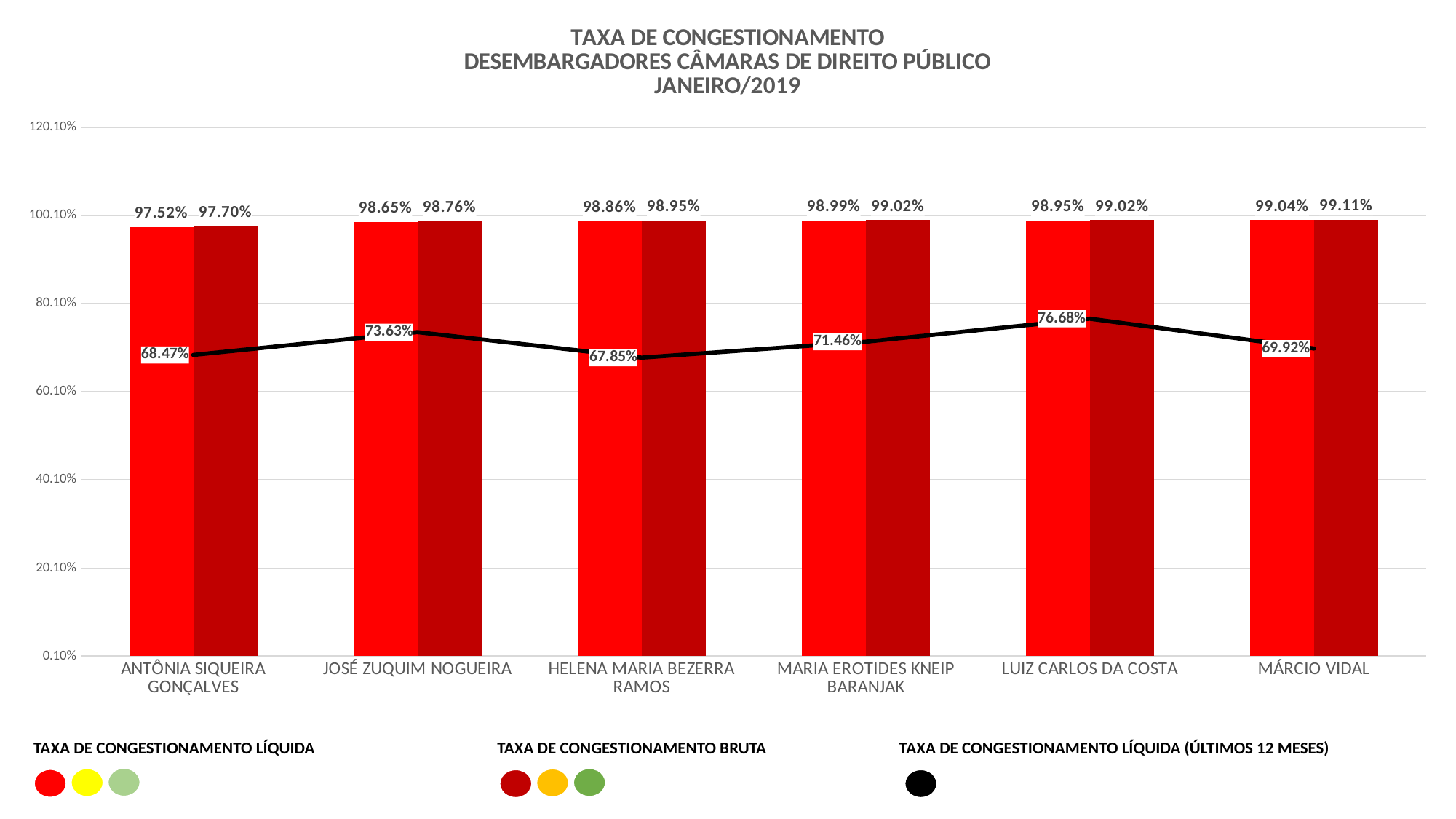
What is the Taxa de Congestionamento Líquida (últimos 12 meses) for Helena Maria Bezerra Ramos? 67.85% What is the Taxa de Congestionamento Bruta for Márcio Vidal? 99.11% Which desembargador has the highest Taxa de Congestionamento Líquida (últimos 12 meses)? Luiz Carlos da Costa What is the Taxa de Congestionamento Líquida for Antônia Siqueira Gonçalves? 97.52% How many desembargadores are shown on the x axis? 6 What is the difference between the Taxa de Congestionamento Bruta and the Taxa de Congestionamento Líquida for José Zuquim Nogueira? 0.11% What kind of chart is this? Bar chart with a line Which is larger: the Taxa de Congestionamento Líquida (últimos 12 meses) for José Zuquim Nogueira or for Maria Erotides Kneip Baranjak? José Zuquim Nogueira What colour is the line for Taxa de Congestionamento Líquida (últimos 12 meses)? Black What is the Taxa de Congestionamento Líquida (últimos 12 meses) for Luiz Carlos da Costa? 76.68% How many series does the legend list? 3 Which desembargador has the lowest Taxa de Congestionamento Bruta? Antônia Siqueira Gonçalves